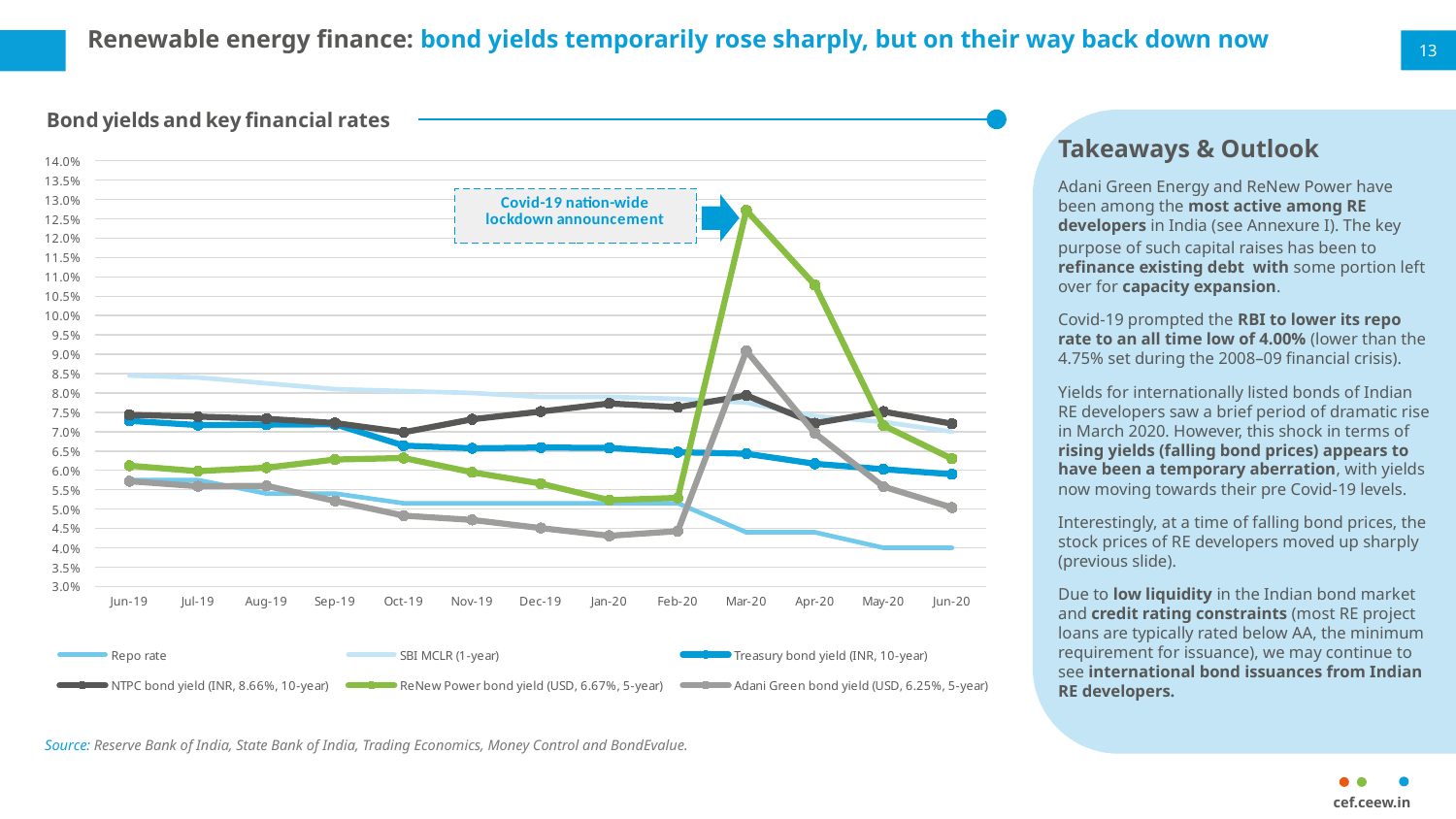
What kind of chart is shown under the title 'Bond yields and key financial rates'? Line chart Is the Treasury bond yield (INR, 10-year) in Jun-20 greater or less than 6.5%? less Which series has the lowest value in Jun-20? Repo rate In Mar-20, which is higher: the ReNew Power bond yield or the Adani Green bond yield? ReNew Power bond yield Which series reaches the highest value on the chart? ReNew Power bond yield (USD, 6.67%, 5-year) How many months are plotted along the x axis of the chart? 13 Is the ReNew Power bond yield in Mar-20 greater or less than 12.0%? greater Is the Adani Green bond yield in Mar-20 greater or less than 8.5%? greater How many series does the legend of the chart list? 6 Does the Repo rate rise or fall from Jun-19 to Jun-20? Fall In which month does the ReNew Power bond yield peak? Mar-20 What event does the dashed callout box on the chart label? Covid-19 nation-wide lockdown announcement